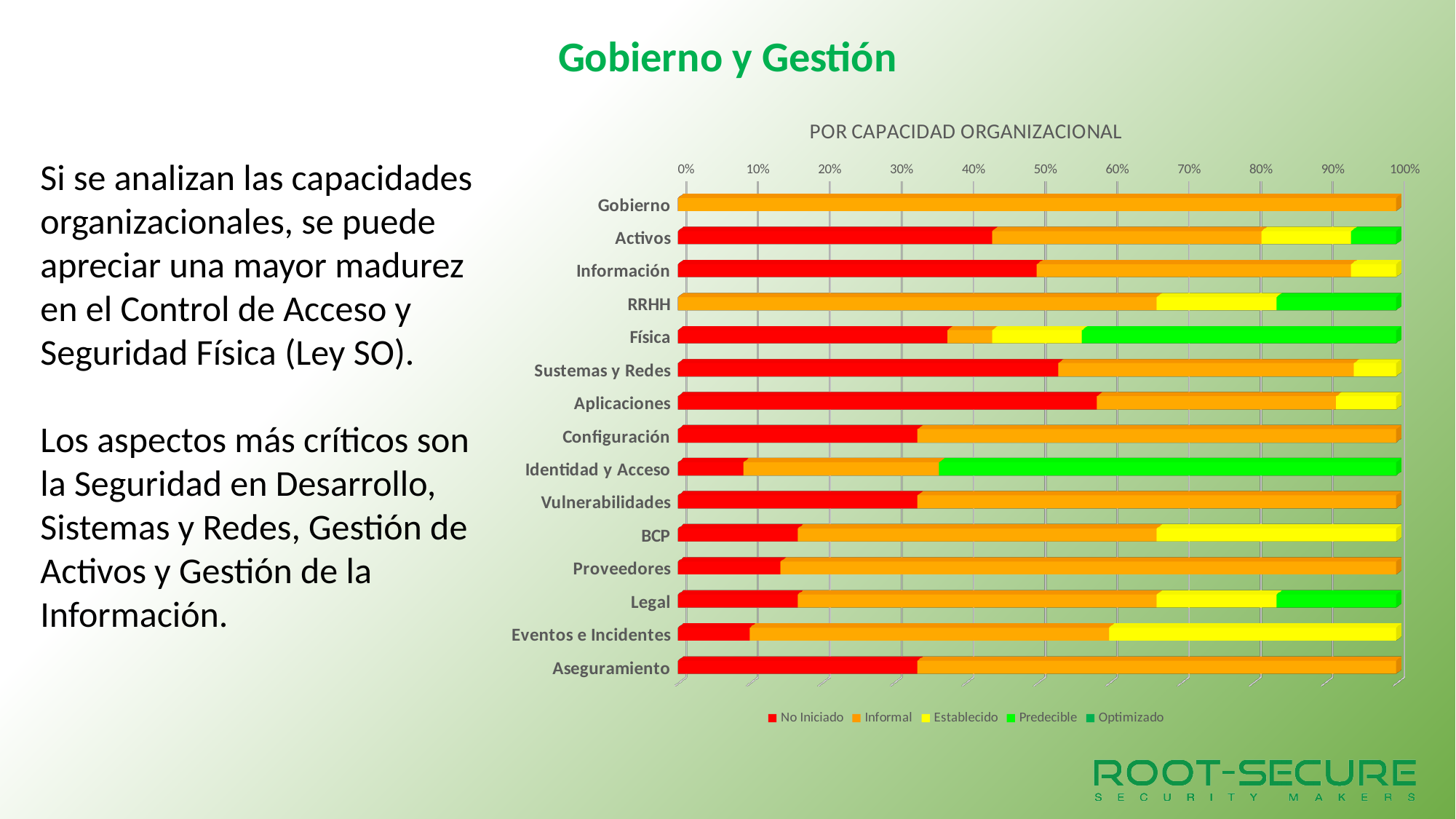
Is the 'No Iniciado' segment larger for Aplicaciones or for Proveedores? Aplicaciones Which category has no 'No Iniciado' segment at all? Gobierno and RRHH How many categories are listed on the vertical axis of the chart? 15 What kind of chart is shown on the slide? Stacked bar chart Which category has the largest 'Predecible' segment? Identidad y Acceso How many series does the chart legend list? 5 Which category has the largest 'No Iniciado' segment? Aplicaciones Is the 'No Iniciado' value for Proveedores greater or less than 20%? less Which colour represents the 'No Iniciado' series in the chart? Red What is the title of the chart? POR CAPACIDAD ORGANIZACIONAL What is the total of the stacked bar for Gobierno? 100% Is the 'No Iniciado' value for Aplicaciones greater or less than 50%? greater